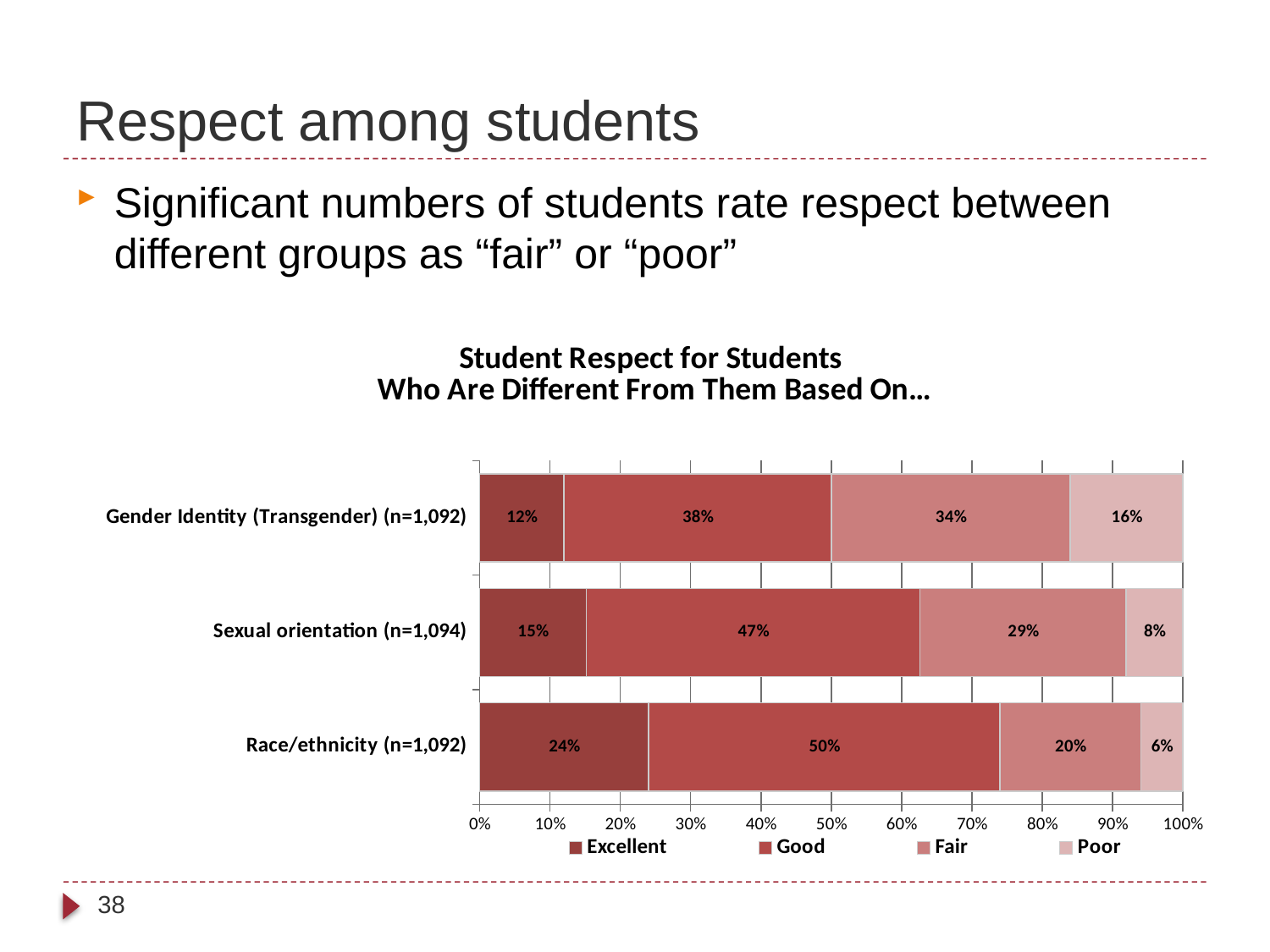
What percentage of students rated respect based on Sexual orientation as Poor? 8% What is the combined Fair and Poor percentage for Gender Identity (Transgender)? 50% What percentage of students rated respect based on Gender Identity (Transgender) as Excellent? 12% Which is larger: the Good rating for Sexual orientation or the Good rating for Gender Identity (Transgender)? Sexual orientation What kind of chart is shown on the slide? Stacked bar chart What is the title of the chart? Student Respect for Students Who Are Different From Them Based On… What is the difference between the Fair rating for Gender Identity (Transgender) and the Fair rating for Race/ethnicity? 14% How many series does the legend list? 4 What percentage of students rated respect based on Race/ethnicity as Good? 50% Which category has the lowest Poor rating? Race/ethnicity (n=1,092) How many categories are shown on the chart? 3 Which category has the highest Excellent rating? Race/ethnicity (n=1,092)